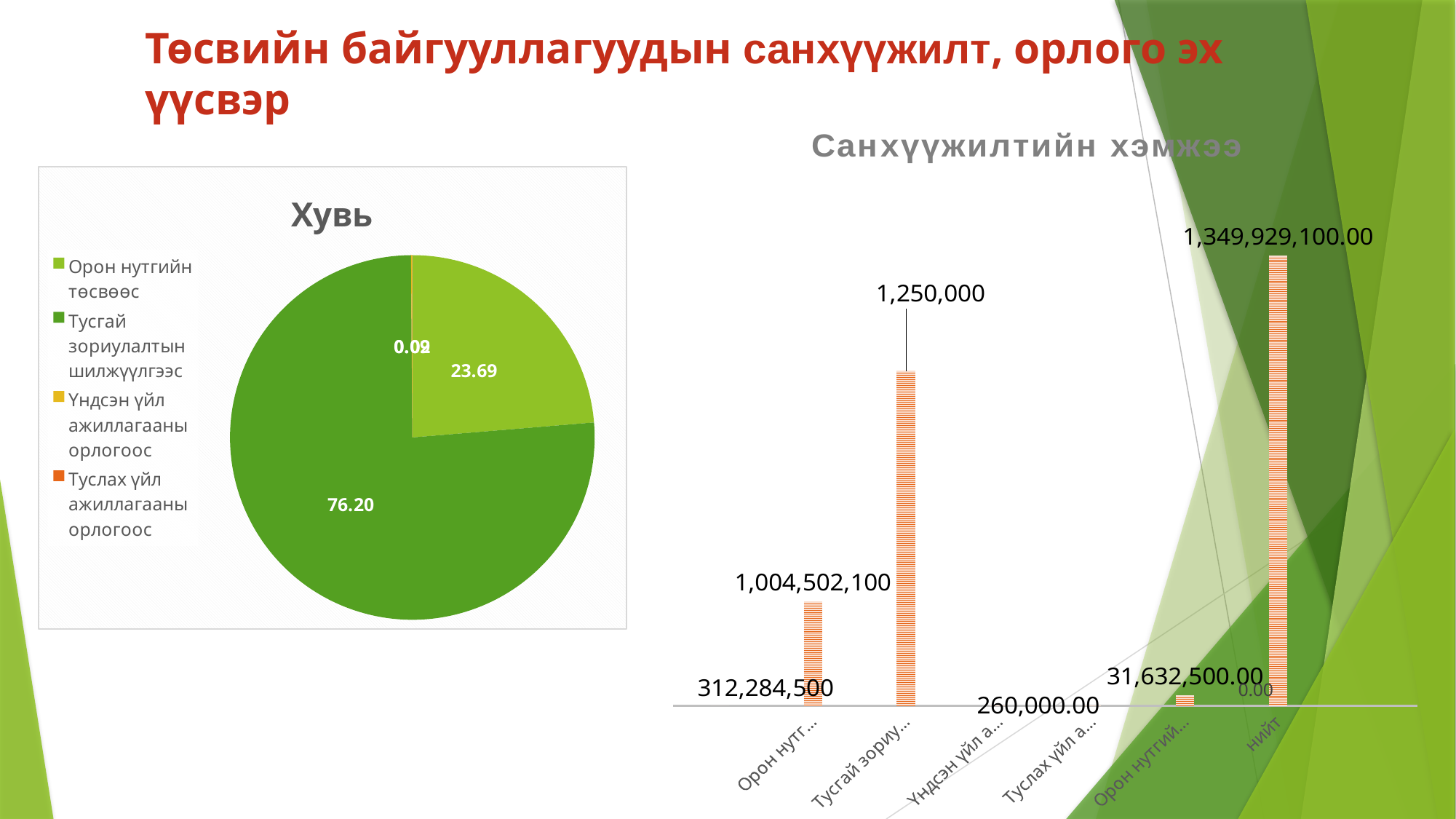
In the chart "Санхүүжилтийн хэмжээ", what is the value labelled for "нийт"? 1,349,929,100.00 In the pie chart "Хувь", what is the difference between the shares of "Тусгай зориулалтын шилжүүлгээс" and "Орон нутгийн төсвөөс"? 52.51 In the pie chart "Хувь", which is larger: the slice for "Орон нутгийн төсвөөс" or the slice for "Тусгай зориулалтын шилжүүлгээс"? Тусгай зориулалтын шилжүүлгээс In the chart "Санхүүжилтийн хэмжээ", how many categories are shown on the x axis? 6 What kind of chart is the chart titled "Санхүүжилтийн хэмжээ"? bar chart In the pie chart "Хувь", what share does "Орон нутгийн төсвөөс" have? 23.69 In the chart "Санхүүжилтийн хэмжээ", which category has the tallest bar? нийт In the pie chart "Хувь", what share does "Тусгай зориулалтын шилжүүлгээс" have? 76.20 What kind of chart is the chart titled "Хувь"? pie chart What is the title of the chart on the right side of the slide? Санхүүжилтийн хэмжээ In the pie chart "Хувь", which category has the largest slice? Тусгай зориулалтын шилжүүлгээс In the pie chart "Хувь", how many categories does the legend list? 4